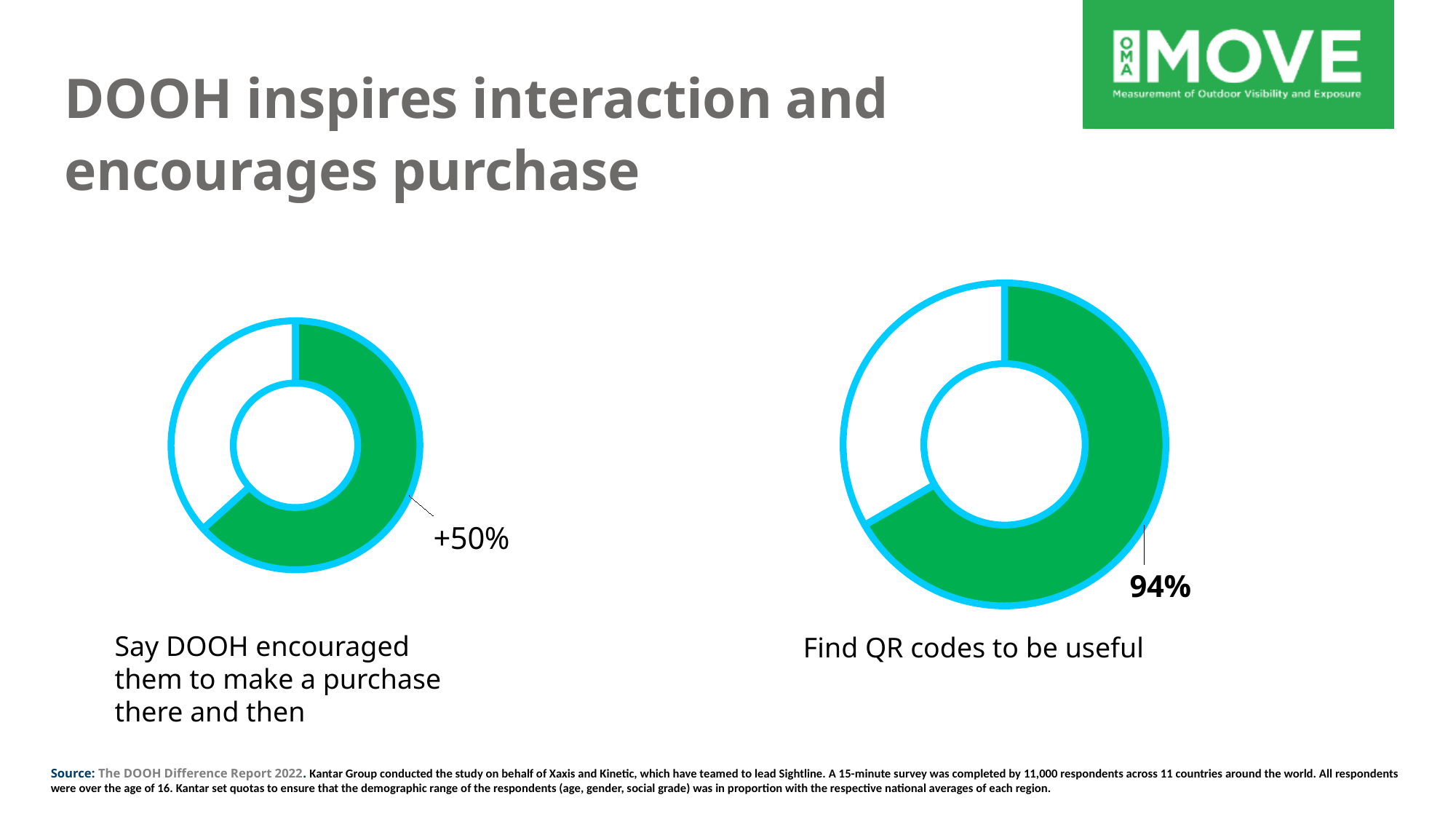
What does the caption under the right donut chart say the 94% represents? Find QR codes to be useful In the right donut chart, what percentage of respondents find QR codes to be useful? 94% What kind of chart is used on the left of the slide for the purchase statistic? Donut chart How many donut charts are shown on the slide? 2 Is the labelled value on the right donut chart (QR codes useful) greater or less than 90%? greater In the left donut chart, what value is shown for the share who say DOOH encouraged them to make a purchase there and then? +50% What is the title of the slide containing the two donut charts? DOOH inspires interaction and encourages purchase Which is larger: the labelled value on the right chart (QR codes useful) or the labelled value on the left chart (encouraged to purchase)? The right chart (94%) What colour is the highlighted segment in both donut charts? Green What kind of chart is used on the right of the slide for the QR code statistic? Donut chart